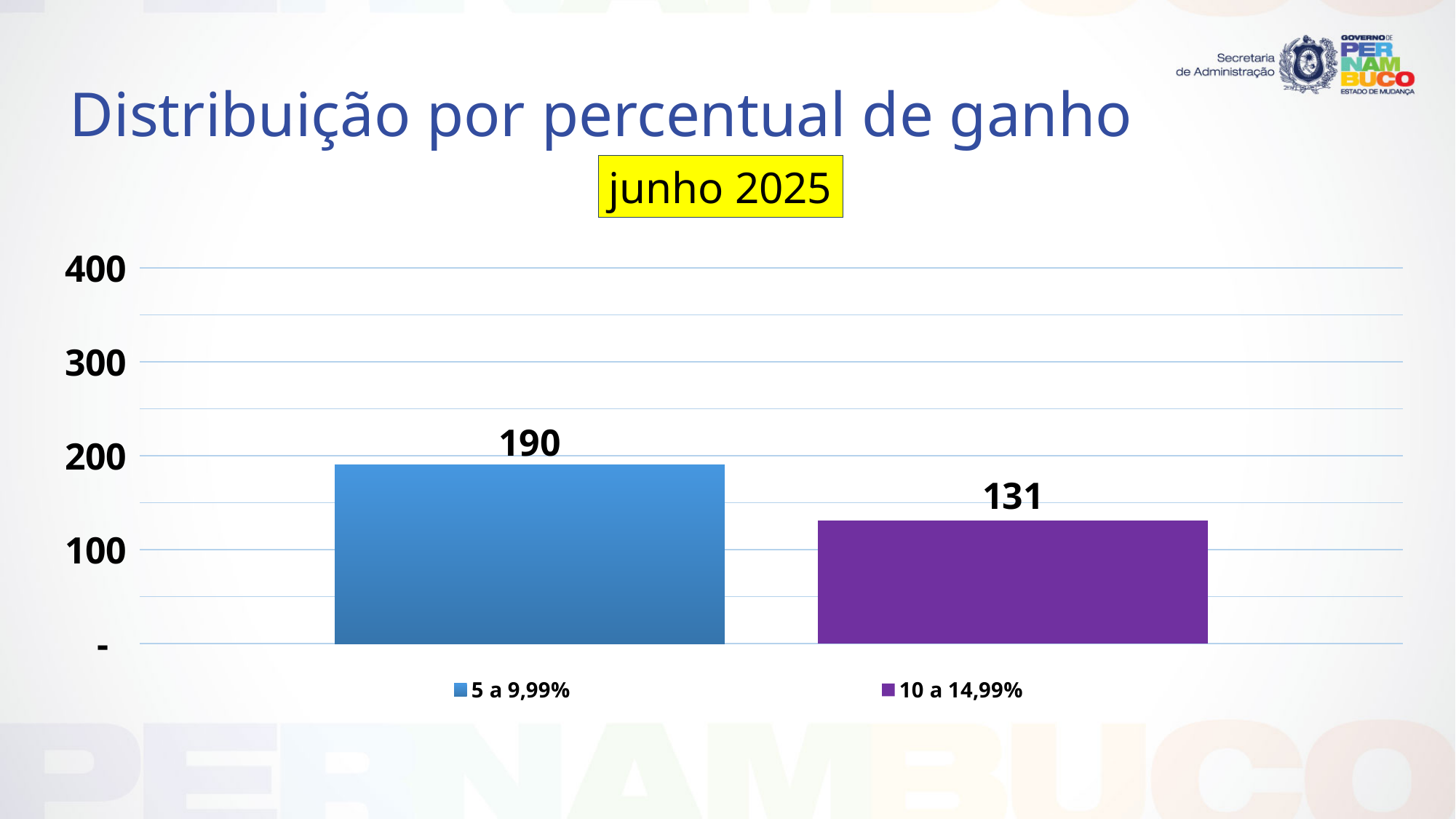
What is the value for the "10 a 14,99%" series? 131 Is the value for "5 a 9,99%" greater or less than 100? greater What kind of chart is shown on the slide? bar chart Which series has the highest value? 5 a 9,99% How many series does the legend list? 2 What is the value for the "5 a 9,99%" series? 190 Which series has the lowest value? 10 a 14,99% Which is larger, the value for "5 a 9,99%" or the value for "10 a 14,99%"? 5 a 9,99% What colour is the bar for the "10 a 14,99%" series? purple What is the difference between the values for "5 a 9,99%" and "10 a 14,99%"? 59 Is the value for "10 a 14,99%" greater or less than 200? less How many bars are plotted on the chart? 2